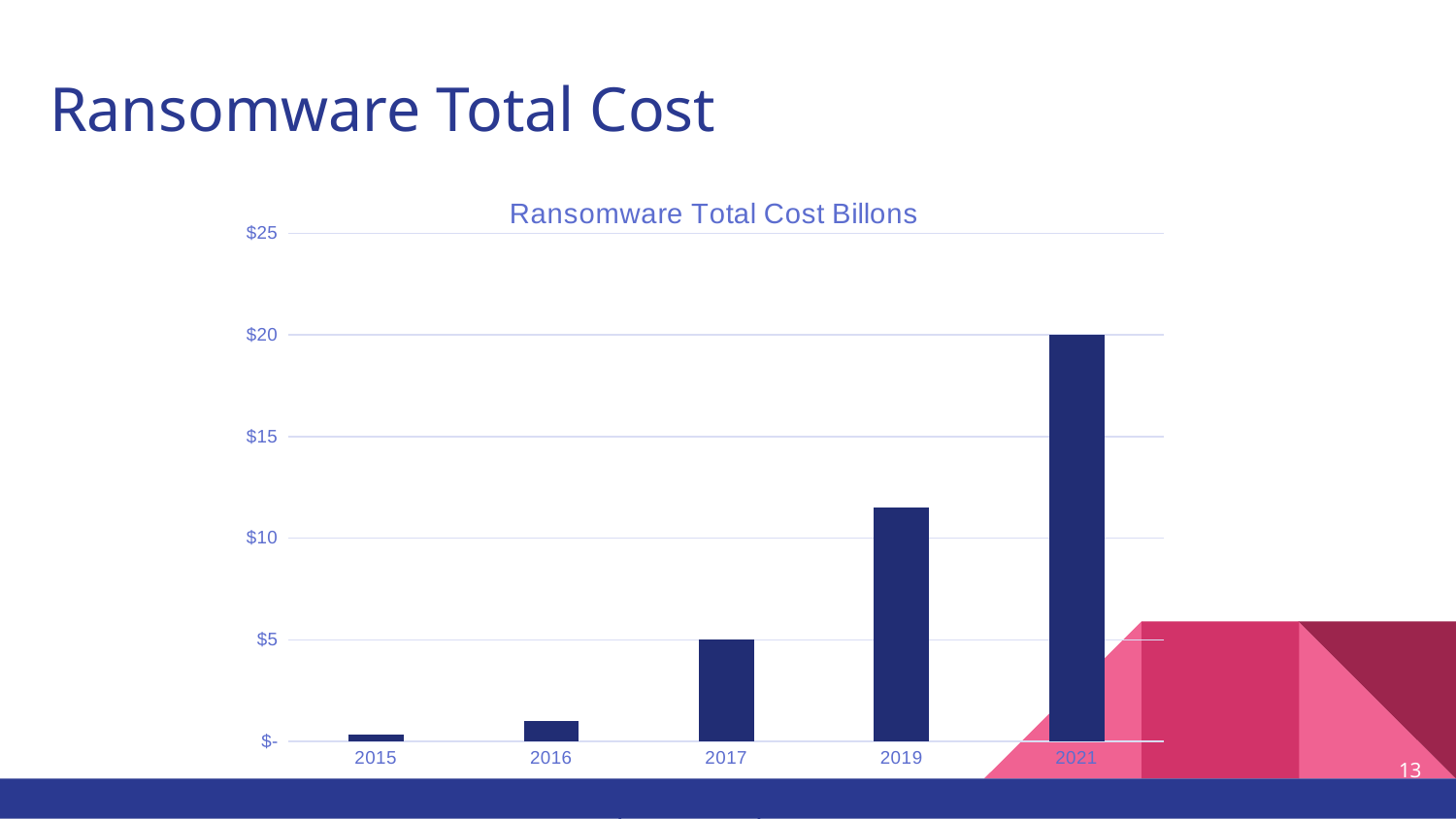
What kind of chart is shown on the slide? bar chart Do the values rise or fall from 2015 to 2021? rise Which year has a larger value, 2017 or 2019? 2019 How many years are shown on the x axis of the chart? 5 Which year has the highest ransomware total cost? 2021 What is the title of the chart? Ransomware Total Cost Billons What is the difference between the values for 2021 and 2017? $15 What is the ransomware total cost for 2017? $5 What is the ransomware total cost for 2021? $20 Is the value for 2019 greater or less than $10? greater Is the value for 2016 greater or less than $5? less Which year has the lowest ransomware total cost? 2015